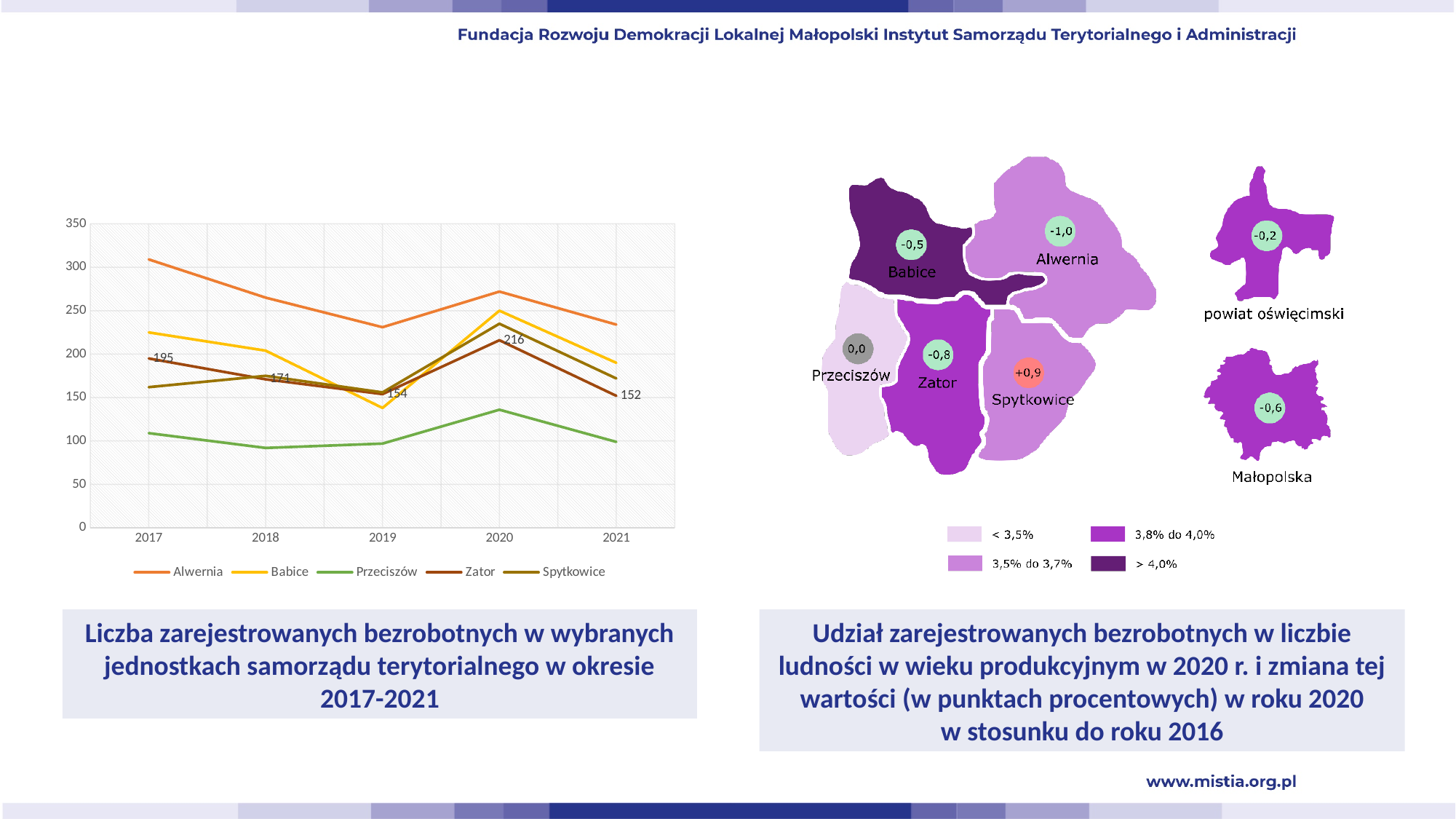
In the line chart on the left, what is the value for Zator in 2017? 195 In the line chart on the left, what is the value for Zator in 2020? 216 In the line chart on the left, what is the value for Zator in 2021? 152 In the line chart on the left, which series has the lowest value in 2020? Przeciszów What kind of chart is the chart titled 'Liczba zarejestrowanych bezrobotnych w wybranych jednostkach samorządu terytorialnego w okresie 2017-2021'? line chart In the line chart on the left, is the value for Alwernia in 2017 greater or less than 300? greater In the line chart on the left, which series has the highest value in 2017? Alwernia In the line chart on the left, by how much did the value for Zator change from 2019 to 2020? 62 How many series does the legend of the line chart on the left list? 5 How many years are shown on the x axis of the line chart on the left? 5 In the line chart on the left, does the value for Alwernia rise or fall from 2017 to 2019? fall In the map on the right, what change value is shown for Spytkowice? +0,9